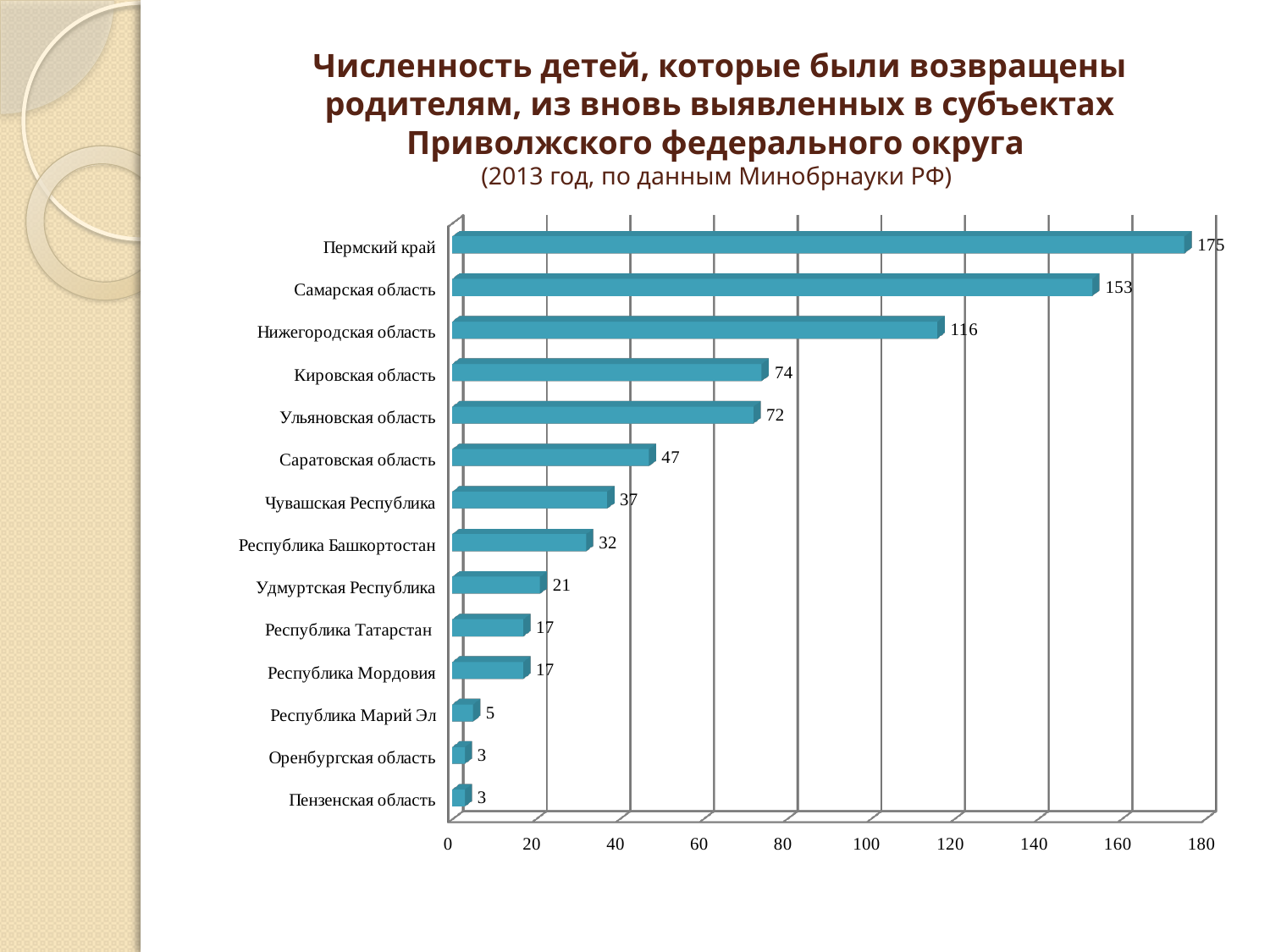
What is the value for Пермский край? 175 What is the value for Удмуртская Республика? 21 What kind of chart is shown on the slide? bar chart Which is larger, the value for Ульяновская область or the value for Республика Башкортостан? Ульяновская область What is the value for Нижегородская область? 116 What is the value for Саратовская область? 47 Which region has the highest value? Пермский край Which year does the chart's subtitle say the data is for? 2013 What is the difference between the values for Пермский край and Самарская область? 22 Is the value for Самарская область greater or less than 140? greater How many regions are shown in the chart? 14 What is the difference between the values for Кировская область and Чувашская Республика? 37